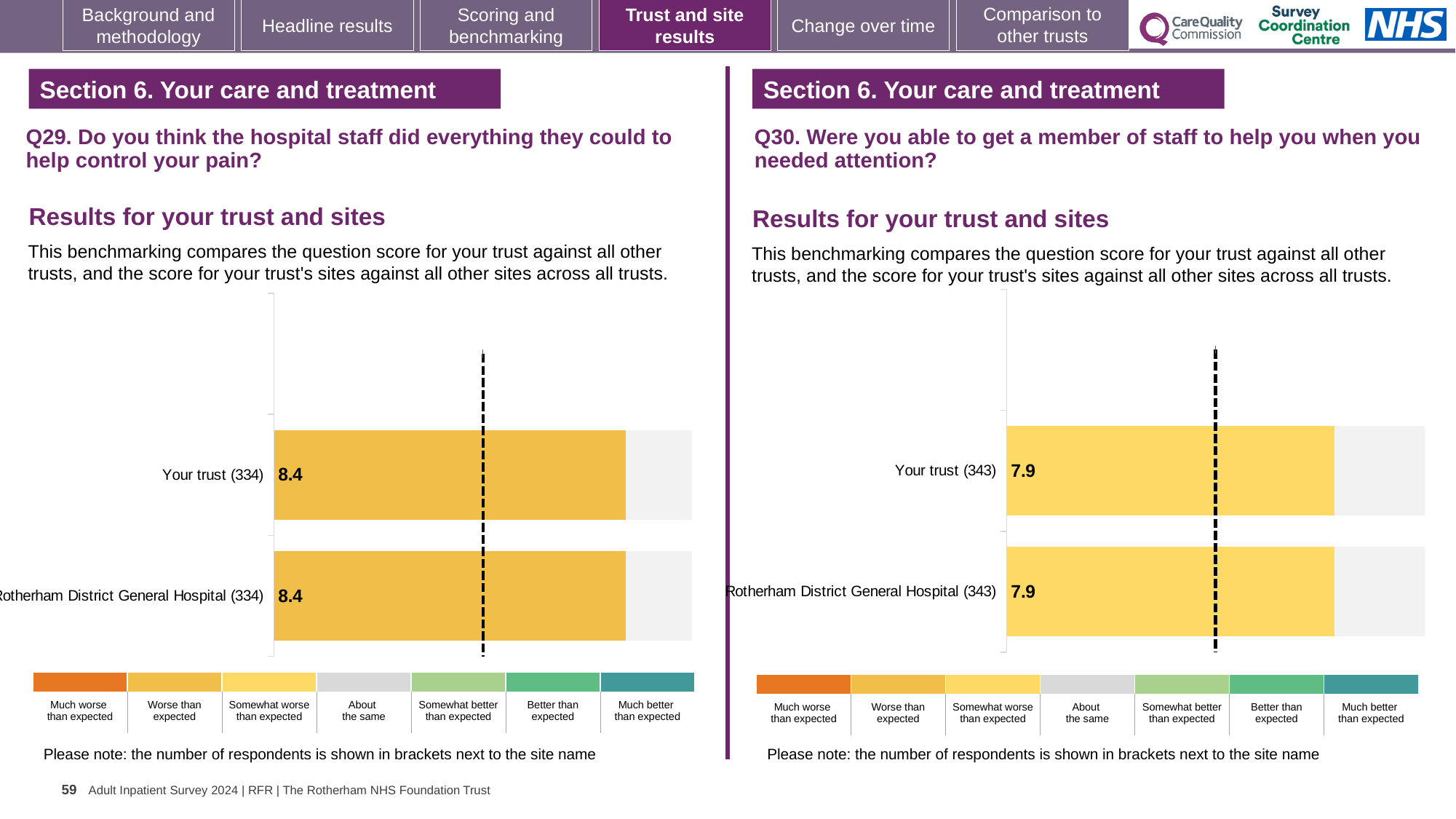
On the Q30 chart (right), what is the score for Your trust? 7.9 According to the legend colour, which benchmark category do the bars on the Q30 chart (right) fall into? Somewhat worse than expected What is the difference between the Your trust score on the Q29 chart (left) and the Your trust score on the Q30 chart (right)? 0.5 On the Q29 chart (left), what is the score for Rotherham District General Hospital? 8.4 On the Q30 chart (right), what is the score for Rotherham District General Hospital? 7.9 What kind of chart is used on the Q29 chart (left)? Bar chart On the Q29 chart (left), how many respondents are shown in brackets for Your trust? 334 On the Q29 chart (left), what is the score for Your trust? 8.4 On the Q29 chart (left), how many bars are plotted? 2 How many benchmark categories does the legend below the Q30 chart (right) list? 7 On the Q30 chart (right), how many bars are plotted? 2 On the Q30 chart (right), how many respondents are shown in brackets for Rotherham District General Hospital? 343